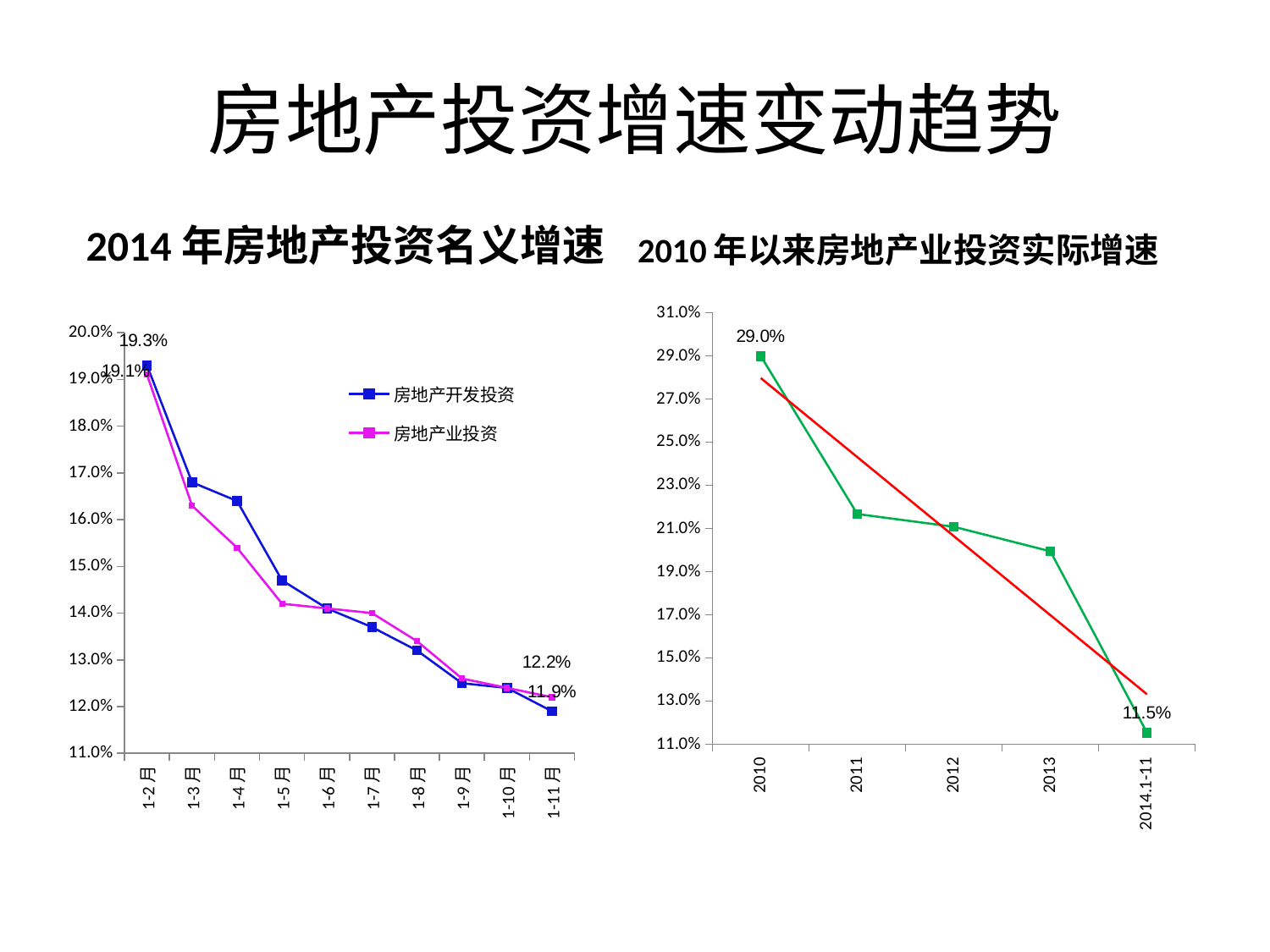
In the left chart (2014年房地产投资名义增速), how many series does the legend list? 2 In the right chart (2010年以来房地产业投资实际增速), is the value for 2011 greater or less than 23.0%? less In the right chart (2010年以来房地产业投资实际增速), what is the value for 2014.1-11? 11.5% In the right chart (2010年以来房地产业投资实际增速), how many data points are plotted on the green line? 5 In the right chart (2010年以来房地产业投资实际增速), what is the value for 2010? 29.0% In the right chart (2010年以来房地产业投资实际增速), do the values rise or fall from 2010 to 2014.1-11? fall In the left chart (2014年房地产投资名义增速), is the value of 房地产开发投资 for 1-5月 greater or less than 15.0%? less In the right chart (2010年以来房地产业投资实际增速), which year has the highest value? 2010 In the left chart (2014年房地产投资名义增速), how many categories are on the x axis? 10 In the left chart (2014年房地产投资名义增速), what is the value of 房地产开发投资 for 1-2月? 19.3% In the right chart (2010年以来房地产业投资实际增速), what is the difference between the 2010 value and the 2014.1-11 value? 17.5 percentage points In the left chart (2014年房地产投资名义增速), what is the value of 房地产业投资 for 1-11月? 12.2%